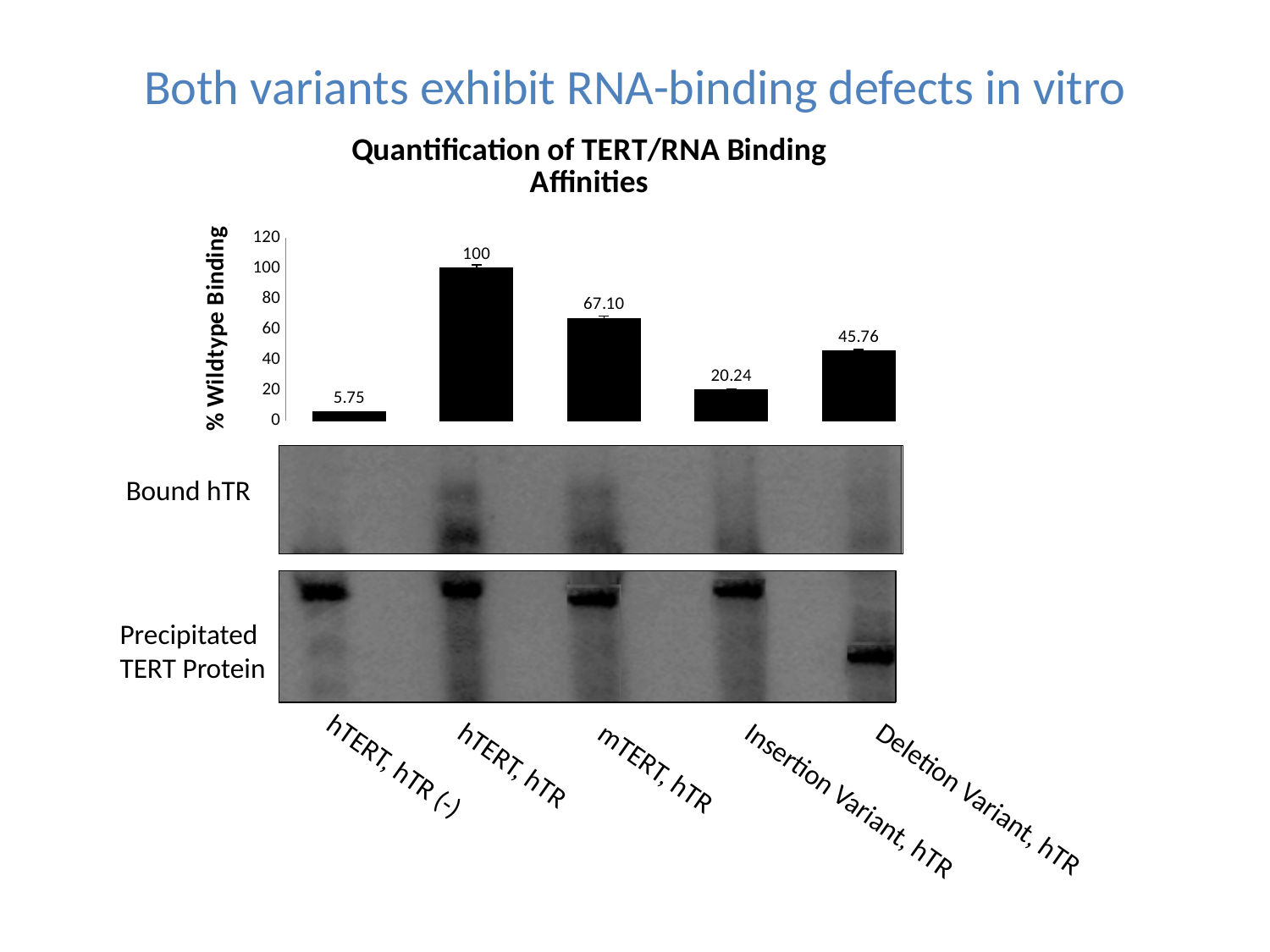
Which category has the lowest % Wildtype Binding? hTERT, hTR (-) What is the difference between the values for Deletion Variant, hTR and Insertion Variant, hTR? 25.52 What kind of chart is shown? bar chart Which is larger, the value for Deletion Variant, hTR or Insertion Variant, hTR? Deletion Variant, hTR How many categories are plotted in the chart? 5 What is the value for mTERT, hTR? 67.10 What is the value for Deletion Variant, hTR? 45.76 Which category has the highest % Wildtype Binding? hTERT, hTR What is the value for hTERT, hTR? 100 What is the value for Insertion Variant, hTR? 20.24 What is the title of the chart? Quantification of TERT/RNA Binding Affinities What is the difference between the values for hTERT, hTR and mTERT, hTR? 32.90